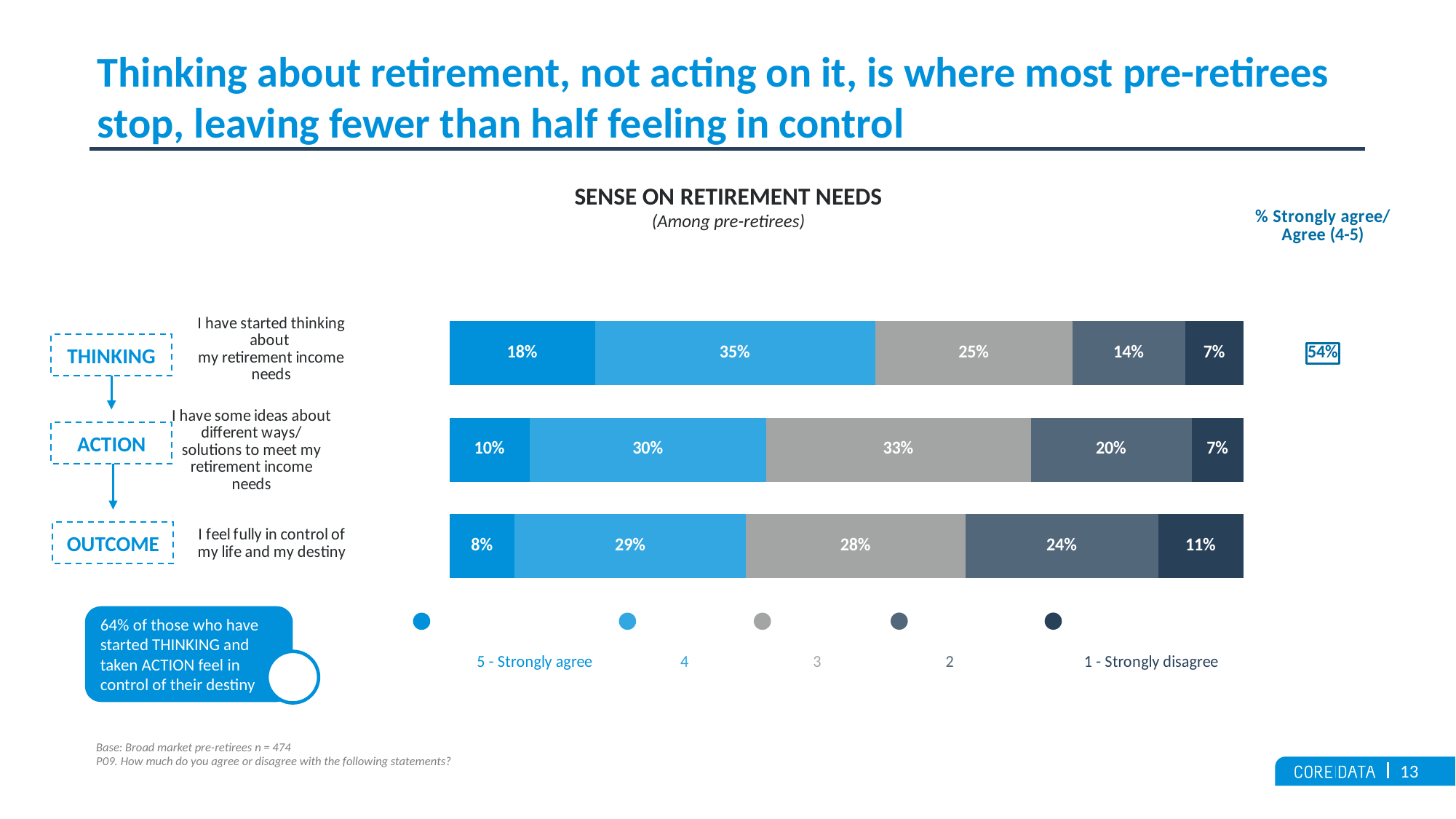
What type of chart is shown on the slide? Stacked bar chart What percentage gave a rating of 3 for the statement 'I have some ideas about different ways/solutions to meet my retirement income needs'? 33% Which statement has the highest share of respondents who strongly agree (5)? I have started thinking about my retirement income needs What is the combined share of ratings 4 and 5 (% Strongly agree/Agree) shown for the THINKING statement? 54% What percentage of pre-retirees strongly agree (5) that they have started thinking about their retirement income needs? 18% What is the difference between the share rating 4 for the THINKING statement and the share rating 4 for the OUTCOME statement? 6 percentage points Which statement has the lowest share of respondents who strongly agree (5)? I feel fully in control of my life and my destiny How many statements (bars) are plotted in the chart? 3 How many series does the legend list? 5 What is the title of the chart? SENSE ON RETIREMENT NEEDS What percentage strongly disagree (1) with the statement 'I feel fully in control of my life and my destiny'? 11% Which is larger: the share rating 2 for the ACTION statement or the share rating 2 for the OUTCOME statement? OUTCOME (24%)